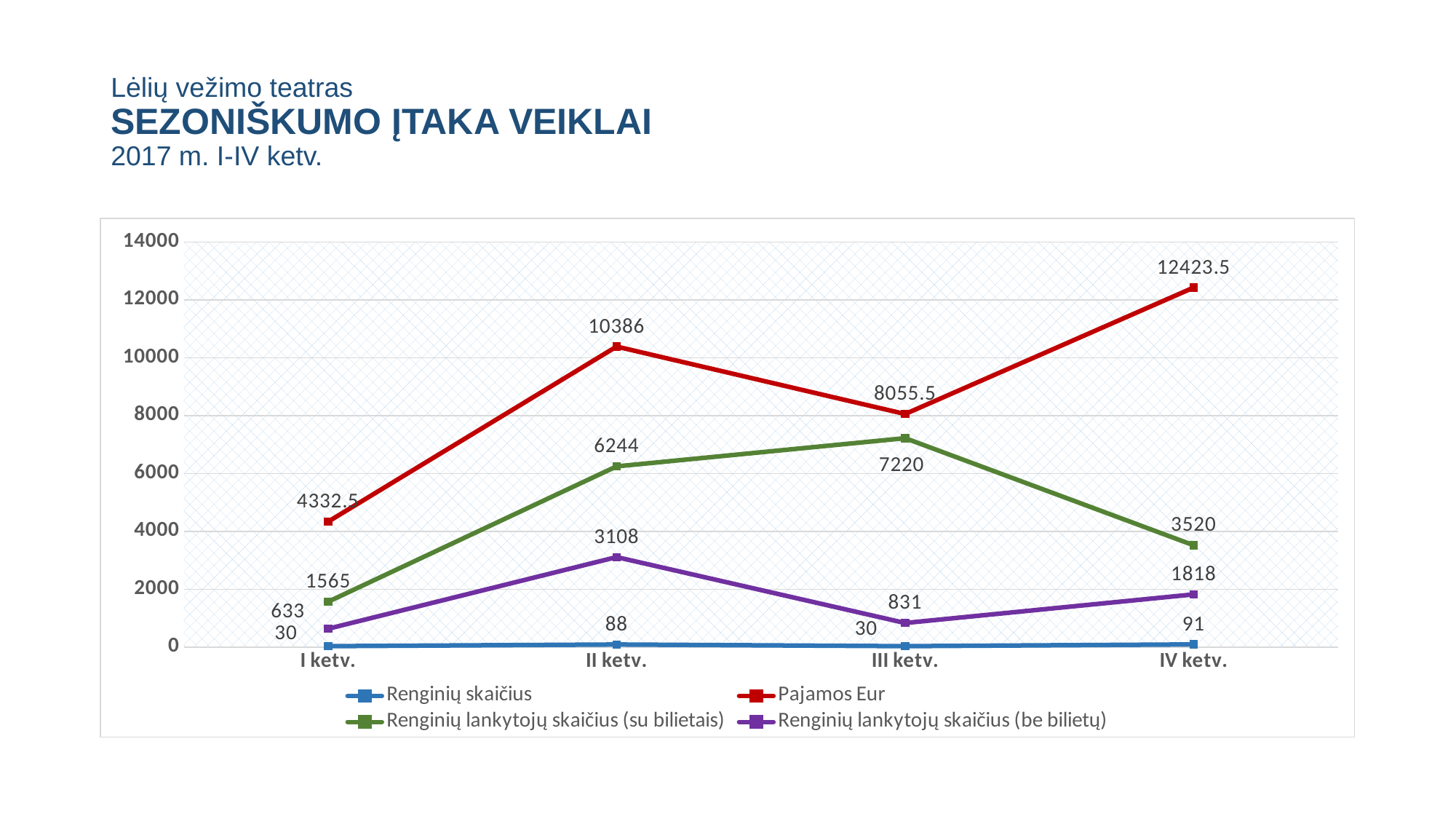
What is the value of Renginių skaičius for II ketv.? 88 Which is larger: Renginių lankytojų skaičius (be bilietų) in II ketv. or in IV ketv.? II ketv. In which quarter is Renginių lankytojų skaičius (su bilietais) lowest? I ketv. How many series does the legend list? 4 In which quarter is Pajamos Eur highest? IV ketv. What is the value of Renginių lankytojų skaičius (be bilietų) for I ketv.? 633 What is the difference between Pajamos Eur in II ketv. and III ketv.? 2330.5 How many quarters are shown on the x axis? 4 Does Renginių lankytojų skaičius (su bilietais) rise or fall from III ketv. to IV ketv.? Fall What kind of chart is shown on the slide? Line chart What is the value of Pajamos Eur for IV ketv.? 12423.5 What is the value of Renginių lankytojų skaičius (su bilietais) for III ketv.? 7220